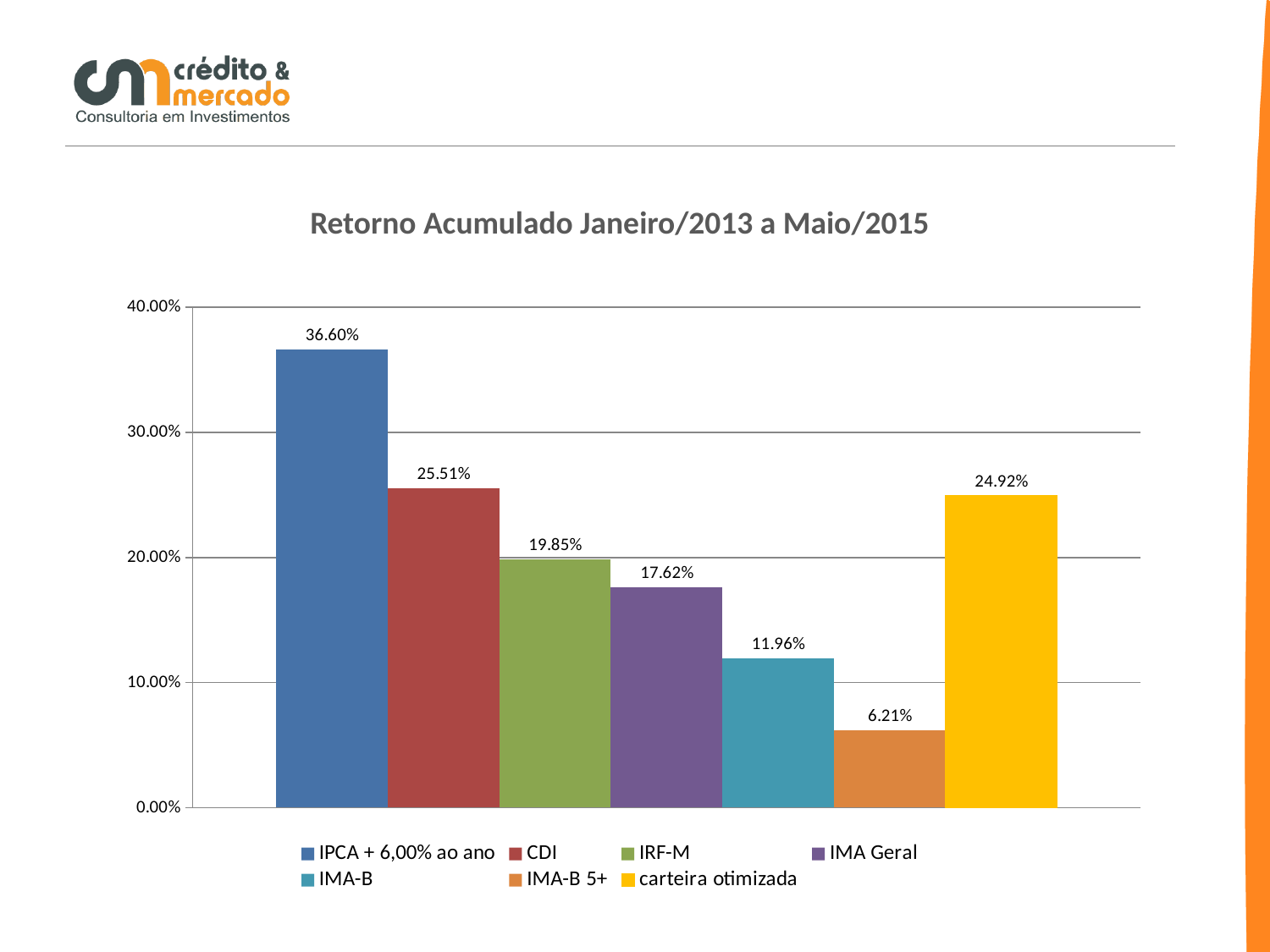
What is the value for IPCA + 6,00% ao ano? 36.60% What is the value for carteira otimizada? 24.92% What is the value for IMA-B 5+? 6.21% Which series has the highest value? IPCA + 6,00% ao ano What kind of chart is shown on the slide? bar chart Is the value for IMA-B greater or less than 10.00%? greater Which is larger, the value for IRF-M or the value for IMA Geral? IRF-M How many series does the legend list? 7 What is the title of the chart? Retorno Acumulado Janeiro/2013 a Maio/2015 What is the difference between the values for CDI and carteira otimizada? 0.59% Which series has the lowest value? IMA-B 5+ How many bars are plotted in the chart? 7